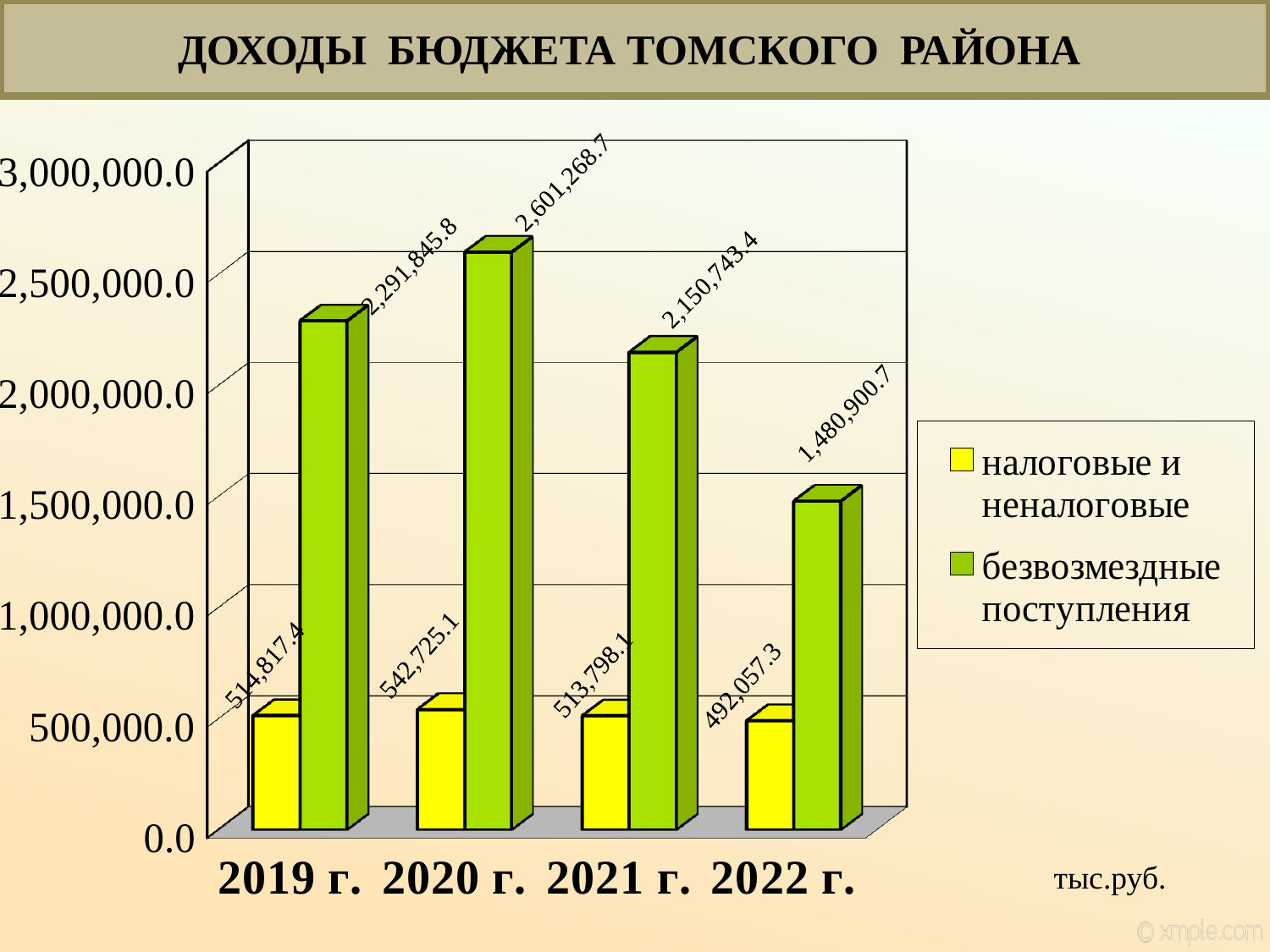
What is the value for безвозмездные поступления in 2020 г.? 2,601,268.7 What is the value for налоговые и неналоговые in 2019 г.? 514,817.4 In which year is налоговые и неналоговые lowest? 2022 г. What is the difference between безвозмездные поступления in 2020 г. and in 2019 г.? 309,422.9 In which year is безвозмездные поступления highest? 2020 г. What kind of chart is shown on the slide? bar chart Which is larger: налоговые и неналоговые in 2020 г. or in 2022 г.? 2020 г. What is the value for налоговые и неналоговые in 2021 г.? 513,798.1 How many years are shown on the x axis? 4 How many series does the legend list? 2 Is the value for безвозмездные поступления in 2021 г. greater or less than 2,000,000.0? greater What is the value for безвозмездные поступления in 2022 г.? 1,480,900.7